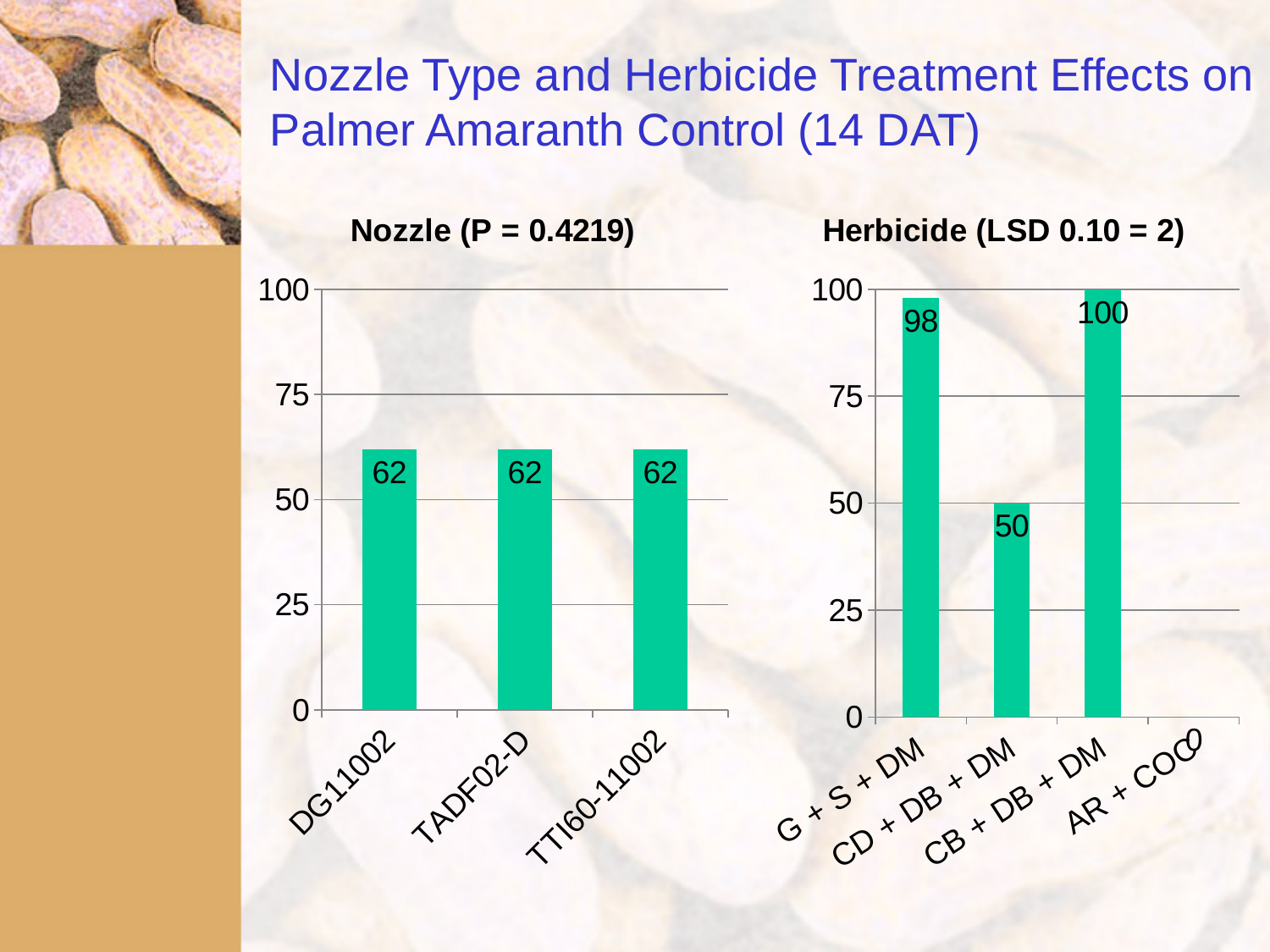
In the Nozzle (P = 0.4219) chart, how many nozzle categories are shown? 3 In the Herbicide (LSD 0.10 = 2) chart, which herbicide treatment has the lowest value? AR + COC In the Nozzle (P = 0.4219) chart, what is the value for TTI60-11002? 62 In the Nozzle (P = 0.4219) chart, what is the value for DG11002? 62 In the Herbicide (LSD 0.10 = 2) chart, what is the value for CD + DB + DM? 50 In the Herbicide (LSD 0.10 = 2) chart, how many herbicide treatment categories are shown on the x axis? 4 In the Herbicide (LSD 0.10 = 2) chart, what is the difference between the values for CB + DB + DM and CD + DB + DM? 50 In the Nozzle (P = 0.4219) chart, is the value for TADF02-D greater or less than 50? greater In the Herbicide (LSD 0.10 = 2) chart, which is larger, the value for G + S + DM or the value for CD + DB + DM? G + S + DM In the Herbicide (LSD 0.10 = 2) chart, which herbicide treatment has the highest value? CB + DB + DM In the Herbicide (LSD 0.10 = 2) chart, what is the value for G + S + DM? 98 What kind of chart is the Nozzle (P = 0.4219) chart? bar chart